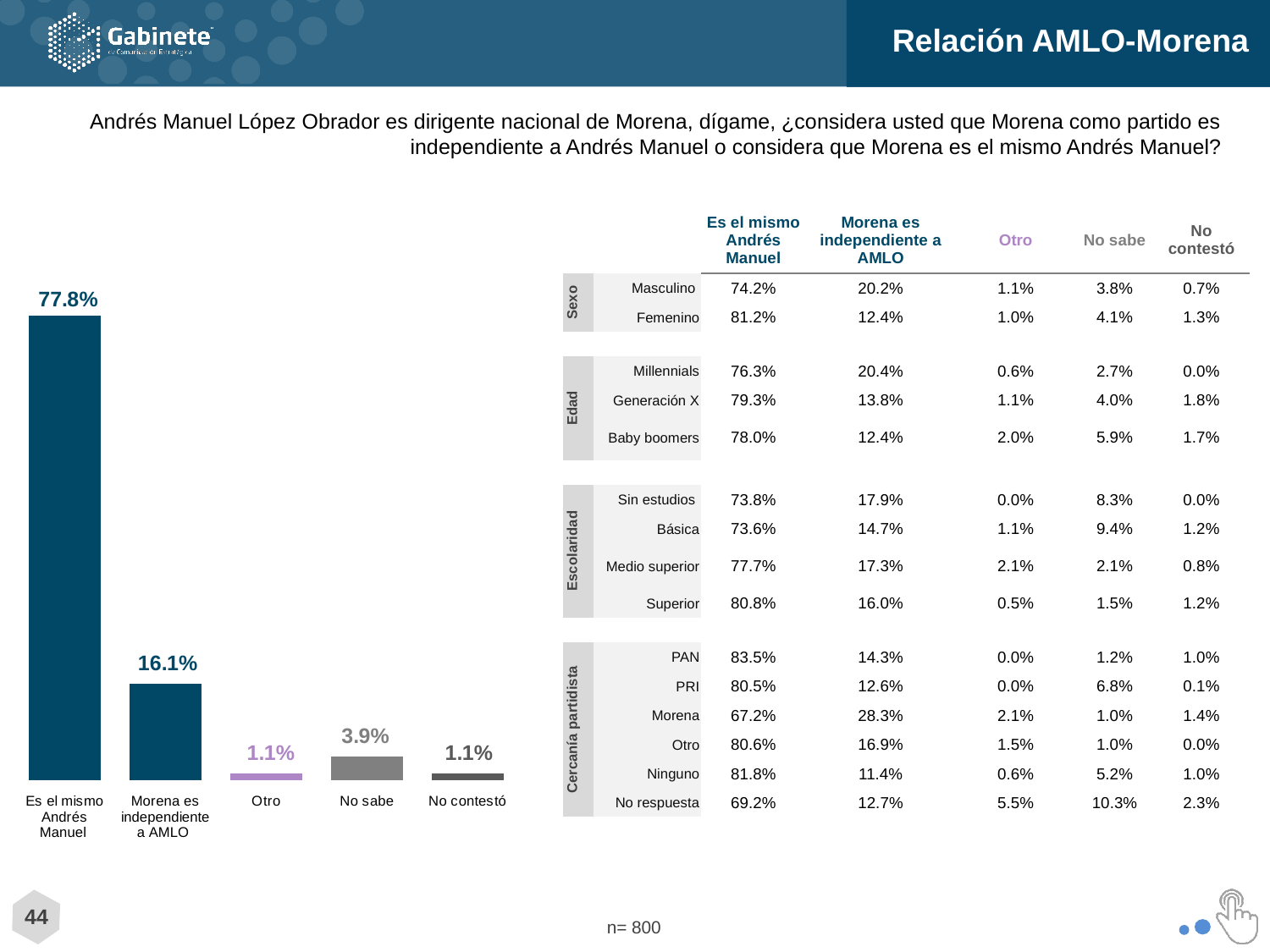
What is the difference between the values for "No sabe" and "No contestó" in the bar chart? 2.8% What value does the bar chart show for "Es el mismo Andrés Manuel"? 77.8% Which category has the highest value in the bar chart? Es el mismo Andrés Manuel What sample size is stated below the bar chart? n= 800 Which two categories in the bar chart share the same value of 1.1%? Otro and No contestó In the bar chart, which is larger: the value for "No sabe" or the value for "Otro"? No sabe What value does the bar chart show for "No sabe"? 3.9% How many categories are shown in the bar chart? 5 What kind of chart is shown on the left of the slide? Bar chart What value does the bar chart show for "Morena es independiente a AMLO"? 16.1% What is the difference between the values for "Es el mismo Andrés Manuel" and "Morena es independiente a AMLO" in the bar chart? 61.7% What value does the bar chart show for "No contestó"? 1.1%